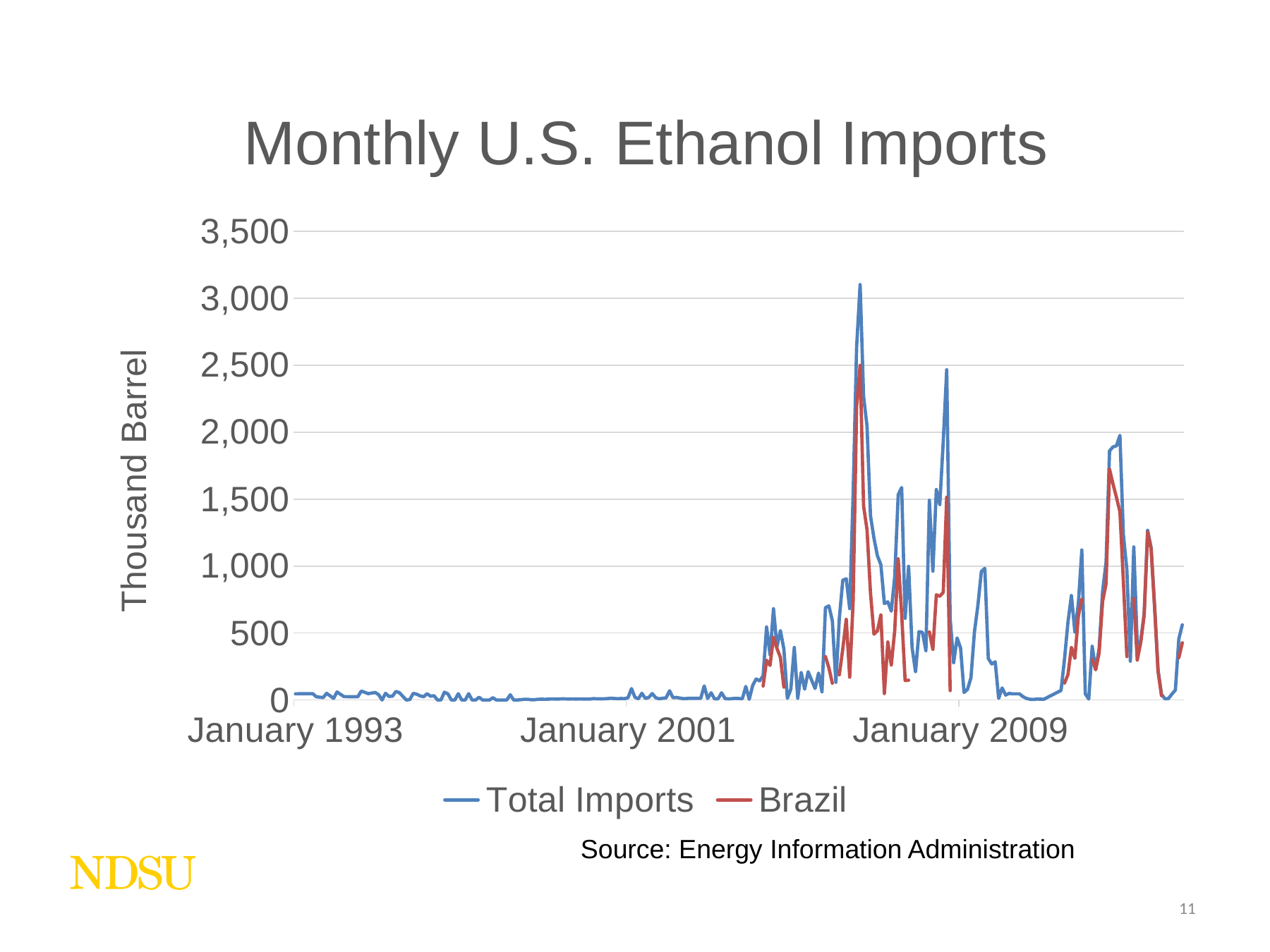
Is the Total Imports value at January 2001 greater or less than 500? less What is the label on the vertical axis? Thousand Barrel Is the highest value reached by the Brazil line greater or less than 2,000? greater Which series is drawn in red? Brazil Which series reaches the higher peak value, Total Imports or Brazil? Total Imports Is the highest value reached by the Total Imports line greater or less than 2,500? greater What kind of chart is shown on the slide? line chart How many series does the legend list? 2 What is the title of the chart? Monthly U.S. Ethanol Imports Between January 1993 and January 2001, do the Total Imports values stay low and flat or rise sharply? stay low and flat